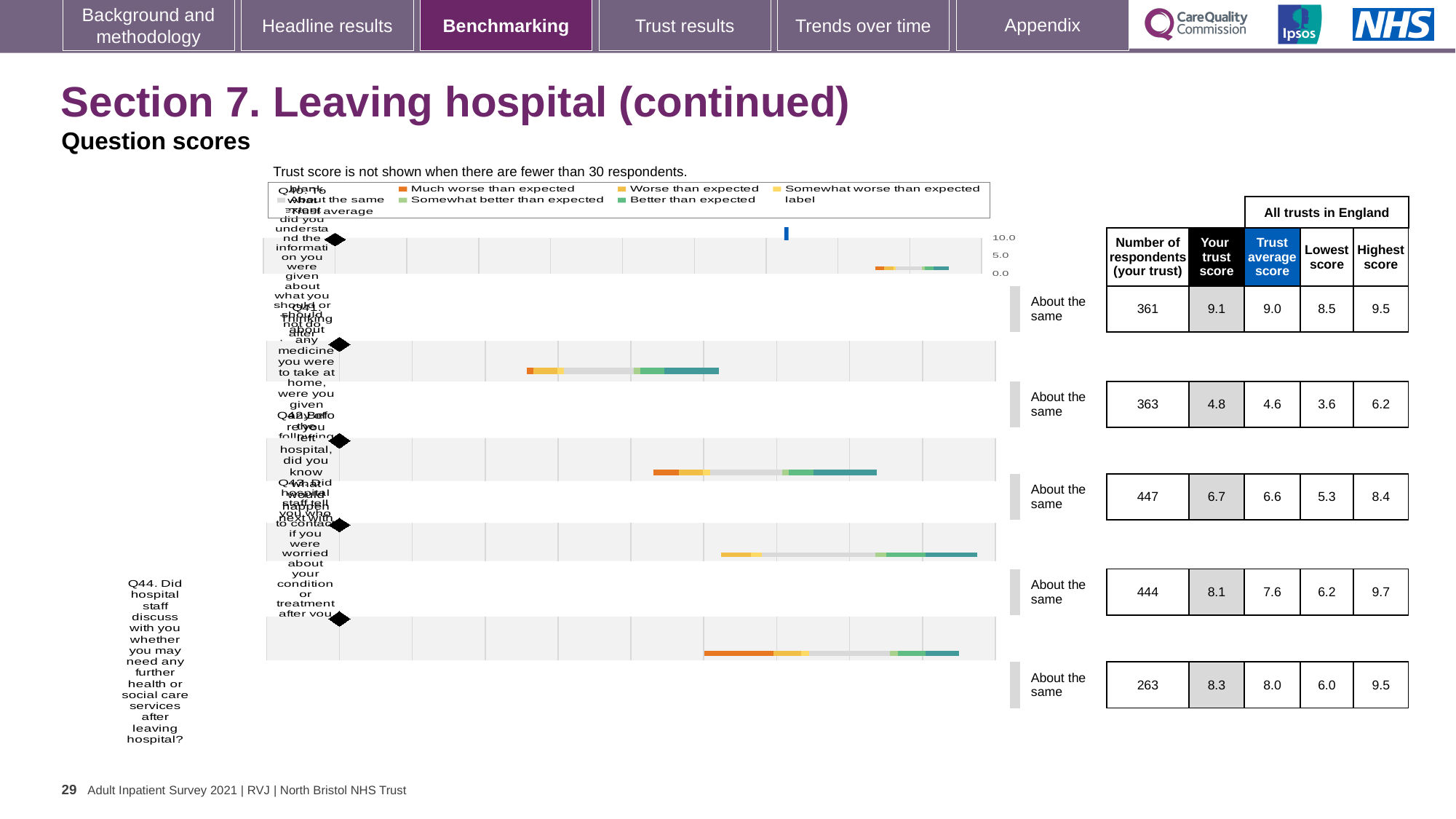
For Q44 (the bottom row), what is your trust score? 8.3 For the top row (Q40), what is your trust score? 9.1 Which row has the lowest 'Your trust score'? The second row (Q41), 4.8 How many question rows (bars) are shown in the chart? 5 For Q44 (the bottom row), which is larger: your trust score or the trust average score? Your trust score Which row has the highest 'Your trust score'? The top row (Q40), 9.1 For Q44 (the bottom row), what is the number of respondents for your trust? 263 For Q44 (the bottom row), what is the trust average score? 8.0 What benchmark category is shown next to each question row in the chart? About the same What kind of chart is used to show the question scores on this slide? bar chart Is your trust score for Q44 (the bottom row) greater or less than 5.0? greater For Q44 (the bottom row), what is the difference between the highest score and the lowest score across all trusts in England? 3.5